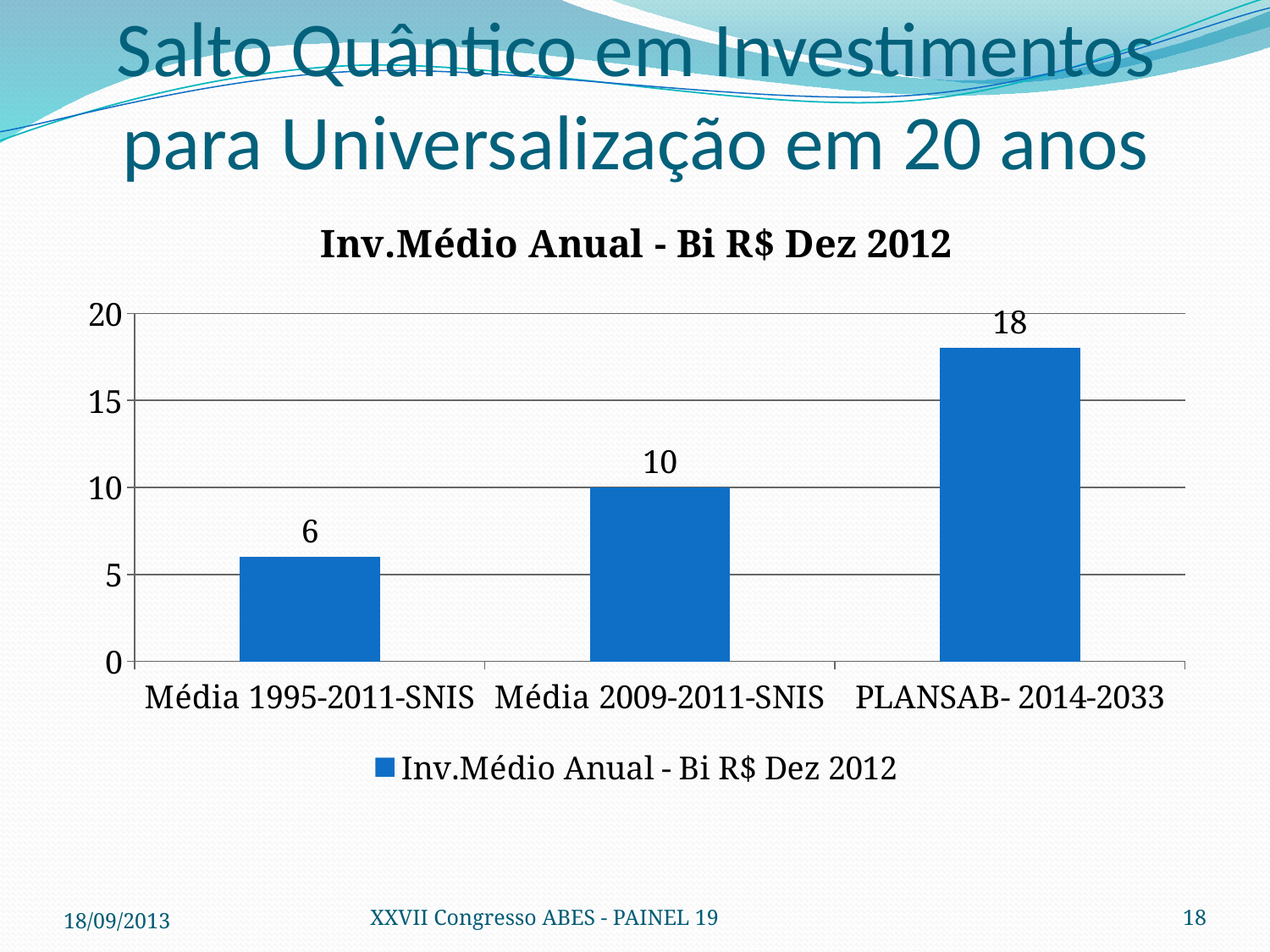
Which is larger, the value for Média 2009-2011-SNIS or the value for Média 1995-2011-SNIS? Média 2009-2011-SNIS What is the difference between the values for Média 2009-2011-SNIS and Média 1995-2011-SNIS? 4 How many categories are shown on the x axis? 3 Which category has the highest value? PLANSAB- 2014-2033 What kind of chart is shown on the slide? bar chart What is the value for PLANSAB- 2014-2033? 18 Which category has the lowest value? Média 1995-2011-SNIS What is the value for Média 2009-2011-SNIS? 10 Is the value for PLANSAB- 2014-2033 greater or less than 15? greater What is the difference between the values for PLANSAB- 2014-2033 and Média 2009-2011-SNIS? 8 What is the value for Média 1995-2011-SNIS? 6 What is the title of the chart? Inv.Médio Anual - Bi R$ Dez 2012